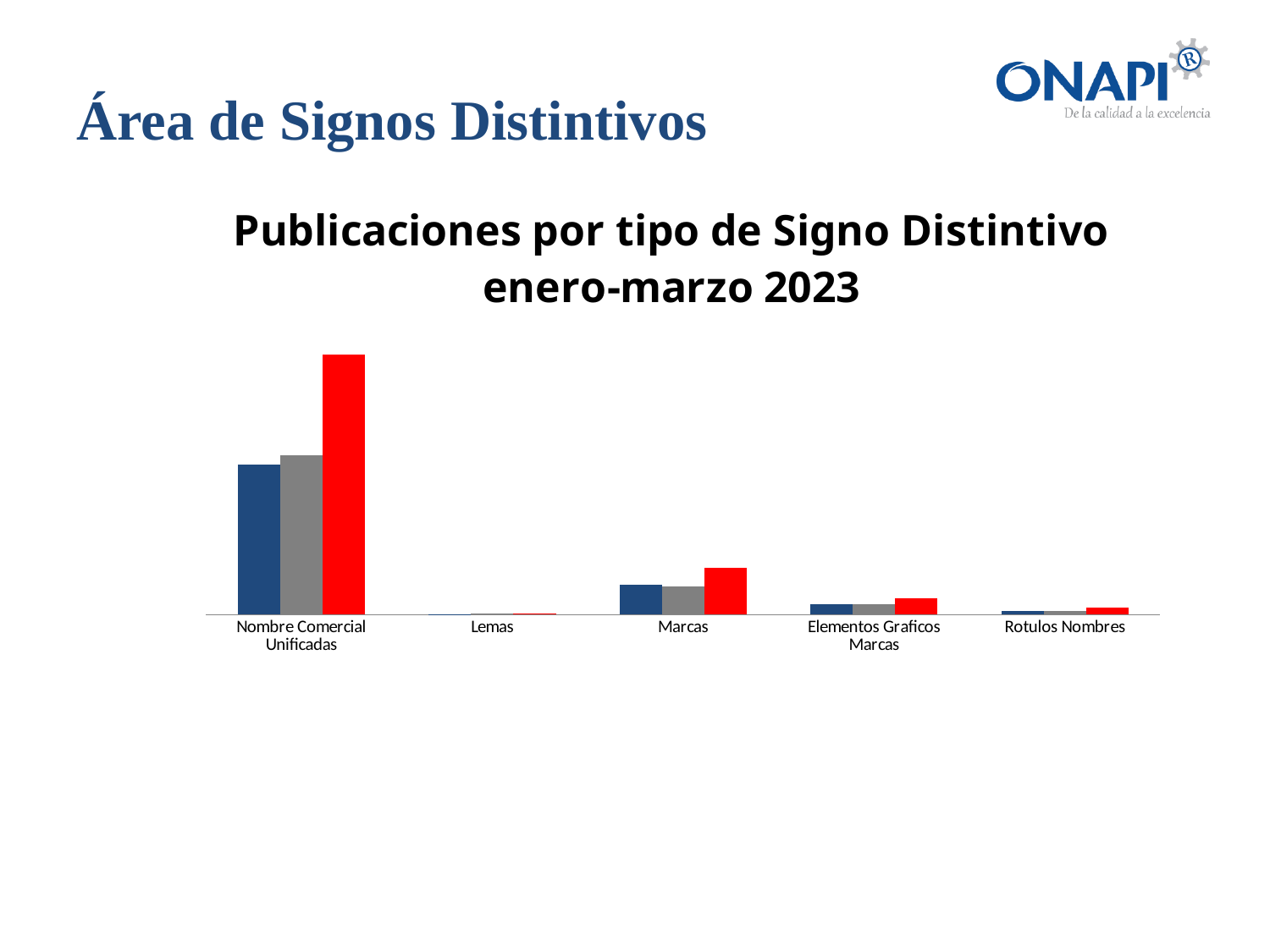
Which category has taller bars, Marcas or Elementos Graficos Marcas? Marcas For Nombre Comercial Unificadas, which coloured bar is the tallest? red How many categories are shown on the x axis of the chart? 5 Which category has the lowest bars in the chart? Lemas How many bars are plotted for each category in the chart? 3 Which category has taller bars, Elementos Graficos Marcas or Rotulos Nombres? Elementos Graficos Marcas What three colours are used for the bars in the chart? blue, gray and red What kind of chart is shown on the slide? bar chart What is the title of the chart? Publicaciones por tipo de Signo Distintivo enero-marzo 2023 Which category has the highest bars in the chart? Nombre Comercial Unificadas